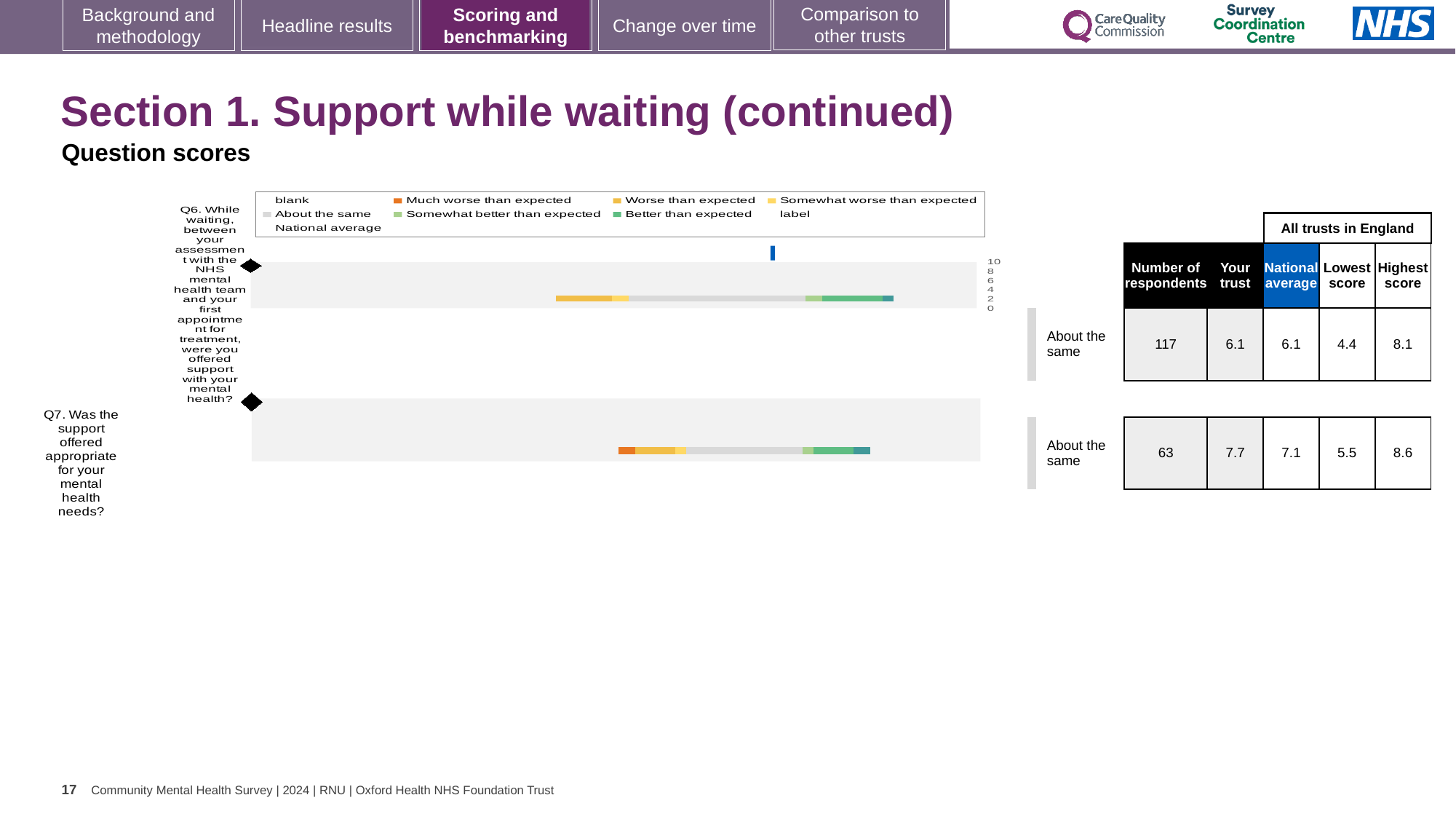
What kind of chart is shown on the slide? bar chart What benchmark rating is shown for Q6 and Q7? About the same How many respondents answered Q6? 117 What is the highest score among all trusts in England for Q7? 8.6 What is the 'Your trust' score for Q7 (was the support offered appropriate for your mental health needs)? 7.7 What is the difference between the 'Your trust' score and the national average for Q7? 0.6 For Q7, which is larger: the 'Your trust' score or the national average? Your trust What is the lowest score among all trusts in England for Q6? 4.4 What is the difference between the highest and lowest scores across all trusts in England for Q6? 3.7 What is the national average score for Q7? 7.1 How many questions (categories) are plotted in the chart? 2 What is the 'Your trust' score for Q6 (support while waiting between assessment and first appointment)? 6.1